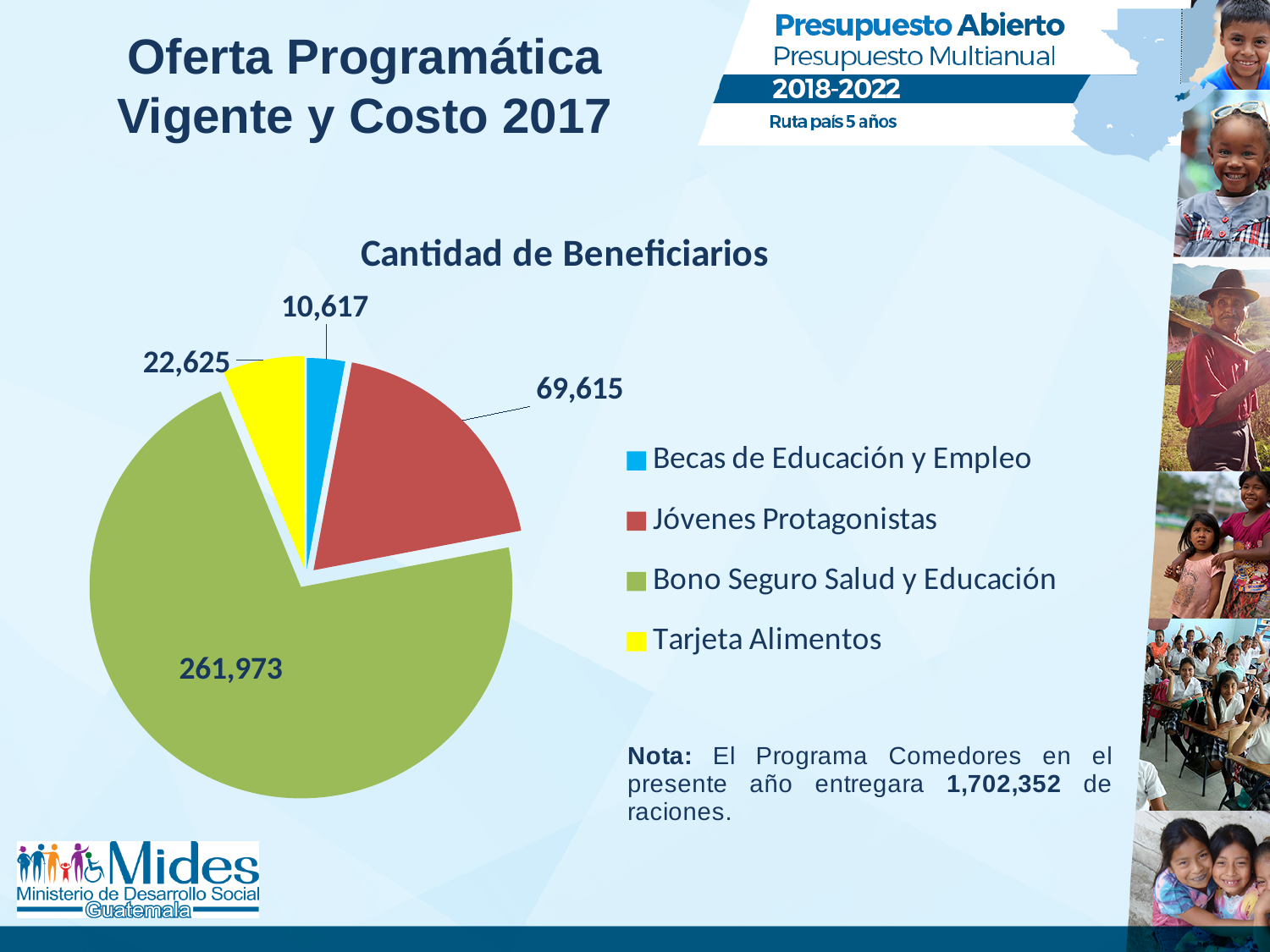
What is the value for Becas de Educación y Empleo? 10,617 What is the value for Jóvenes Protagonistas? 69,615 What is the difference between the values for Bono Seguro Salud y Educación and Jóvenes Protagonistas? 192,358 What is the value for Tarjeta Alimentos? 22,625 Which program has the smallest number of beneficiaries? Becas de Educación y Empleo Which is larger, the value for Jóvenes Protagonistas or the value for Tarjeta Alimentos? Jóvenes Protagonistas Which program has the largest number of beneficiaries? Bono Seguro Salud y Educación What type of chart is shown on the slide? Pie chart How many programs (slices) does the pie chart show? 4 What is the title of the chart? Cantidad de Beneficiarios What is the difference between the values for Tarjeta Alimentos and Becas de Educación y Empleo? 12,008 How many beneficiaries does the chart show for Bono Seguro Salud y Educación? 261,973